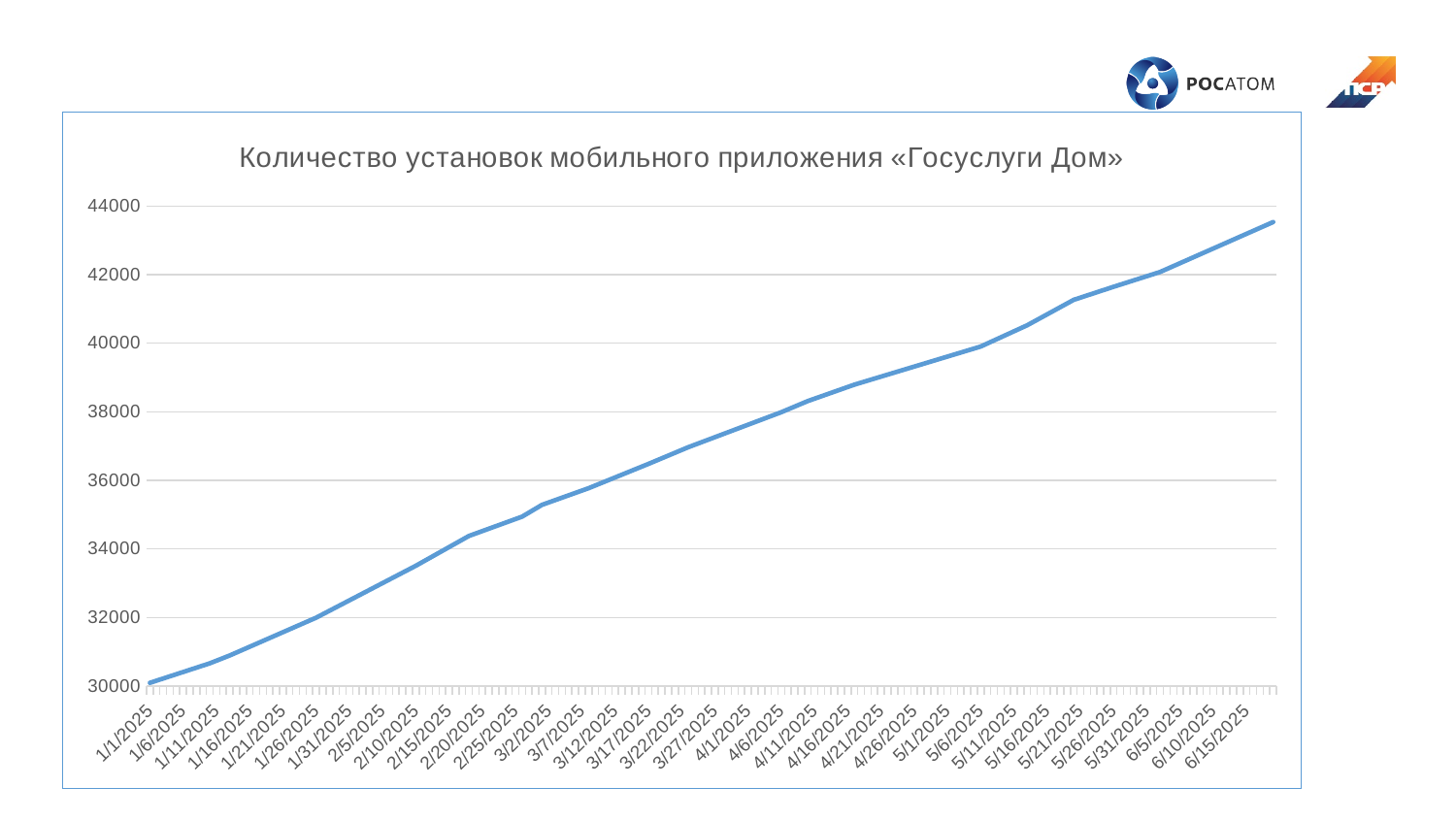
Is the value for 1/11/2025 greater or less than 32000? less Is the value for 6/15/2025 greater or less than 42000? greater Is the value for 4/1/2025 greater or less than 38000? less Do the values rise or fall along the x axis from 1/1/2025 to 6/15/2025? rise Which is larger, the value for 5/1/2025 or the value for 3/2/2025? 5/1/2025 What is the title of the chart? Количество установок мобильного приложения «Госуслуги Дом» What kind of chart is shown on the slide? line chart Which date has the lowest value on the chart? 1/1/2025